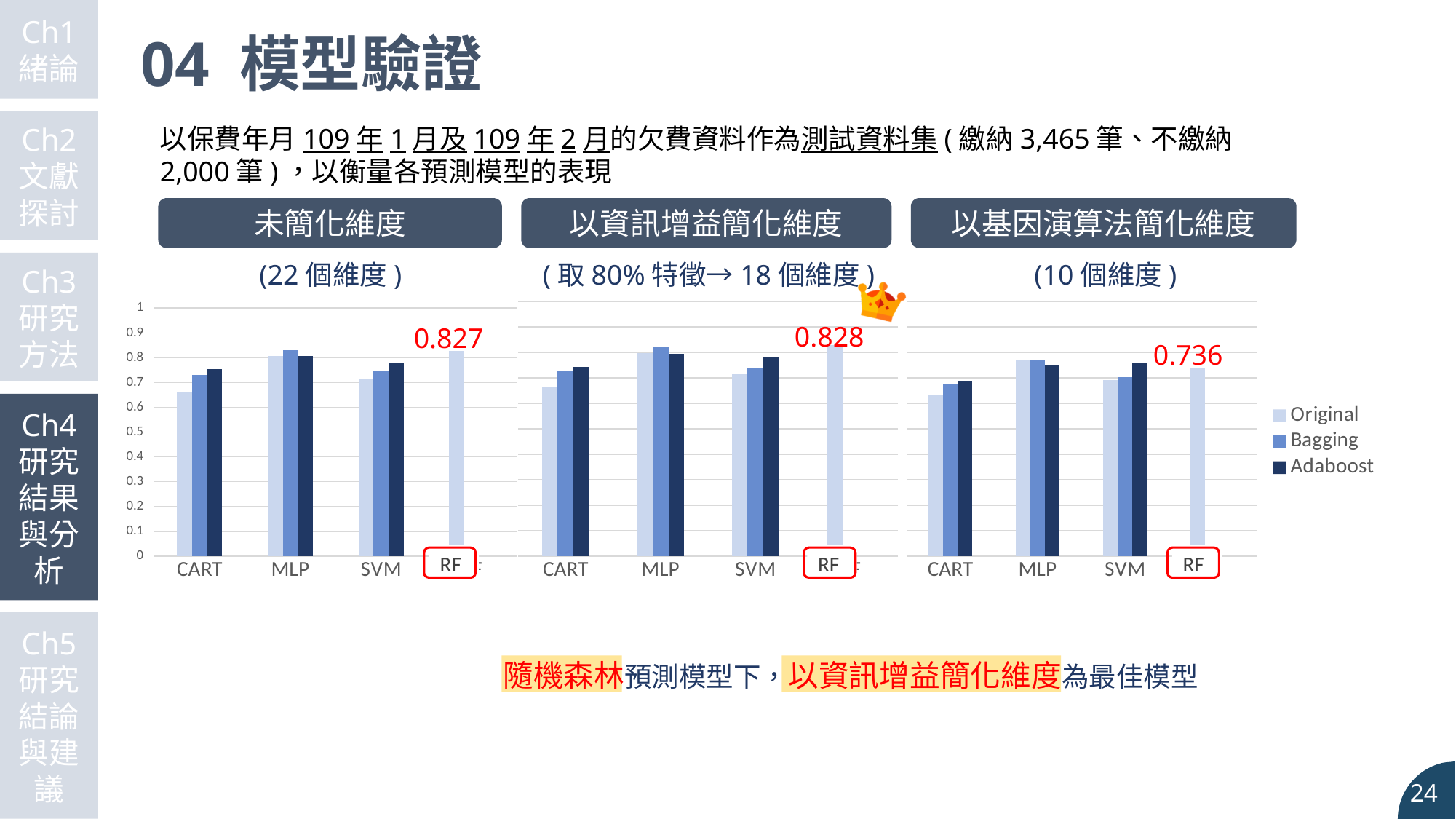
What are the three series names listed in the legend? Original, Bagging, Adaboost In the 以資訊增益簡化維度 chart, is the Bagging value for MLP greater or less than 0.8? greater What kind of chart is the 以基因演算法簡化維度 chart? bar chart In the 以資訊增益簡化維度 chart, what is the value labelled for RF? 0.828 What is the difference between the labelled RF values in the 以資訊增益簡化維度 chart and the 以基因演算法簡化維度 chart? 0.092 In the 未簡化維度 chart, is the Original value for CART greater or less than 0.7? less How many series does the legend list for the charts? 3 How many categories are shown on the x axis of the 未簡化維度 chart? 4 Which chart has the higher labelled RF value, 未簡化維度 or 以資訊增益簡化維度? 以資訊增益簡化維度 In the 未簡化維度 chart, what is the value labelled for RF? 0.827 In the 以基因演算法簡化維度 chart, what is the value labelled for RF? 0.736 In the 以基因演算法簡化維度 chart, which category has the lowest Original value? CART